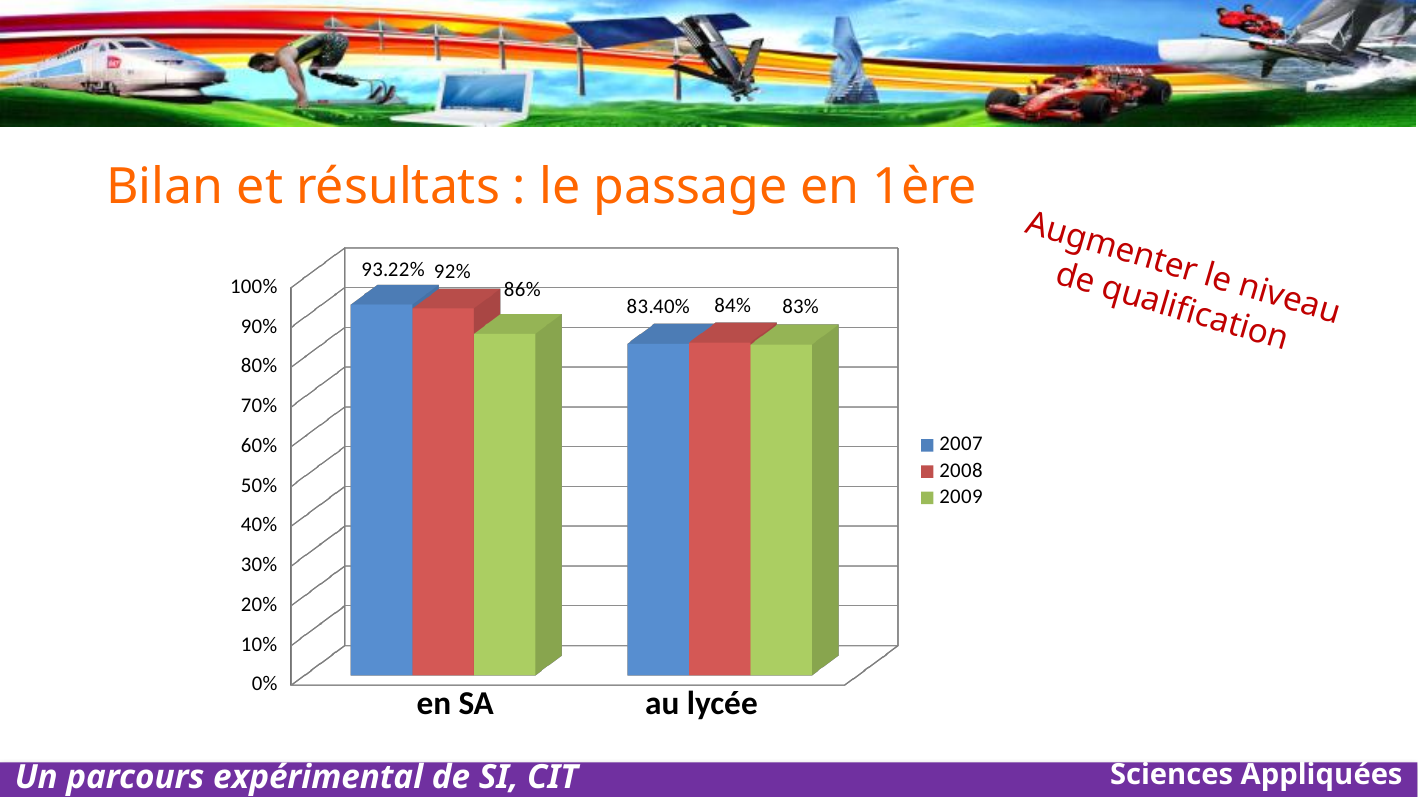
What is the value for 2008 in the 'en SA' category? 92% What is the difference between the 2008 value for 'en SA' and the 2008 value for 'au lycée'? 8% Which is larger: the 2009 value for 'en SA' or the 2009 value for 'au lycée'? en SA What is the value for 2007 in the 'en SA' category? 93.22% What kind of chart is shown on the slide? Bar chart Which year has the highest value in the 'en SA' category? 2007 How many categories are shown on the x axis? 2 Which colour represents the 2008 series in the legend? Red What is the value for 2007 in the 'au lycée' category? 83.40% How many series does the legend list? 3 Which year has the lowest value in the 'en SA' category? 2009 What is the value for 2009 in the 'au lycée' category? 83%